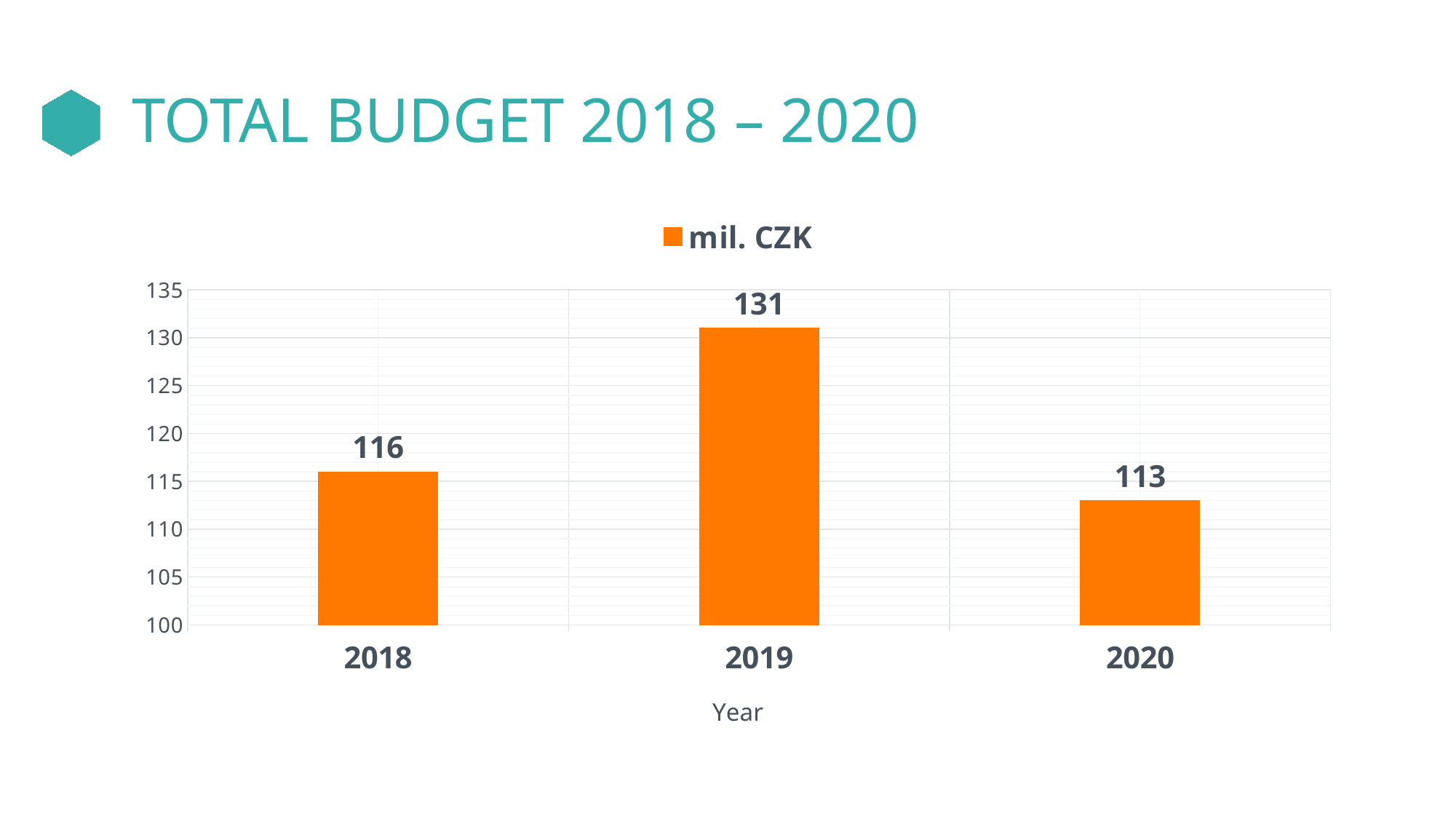
How many years are shown on the x axis? 3 Is the value for 2019 greater or less than 125? greater What is the value for 2020? 113 What is the difference between the values for 2018 and 2020? 3 What kind of chart is shown on the slide? bar chart Which year has the lowest value? 2020 Which is larger, the value for 2019 or the value for 2020? 2019 What is the value for 2018? 116 What is the value for 2019? 131 Which year has the highest value? 2019 What series does the legend list? mil. CZK What is the difference between the values for 2019 and 2018? 15